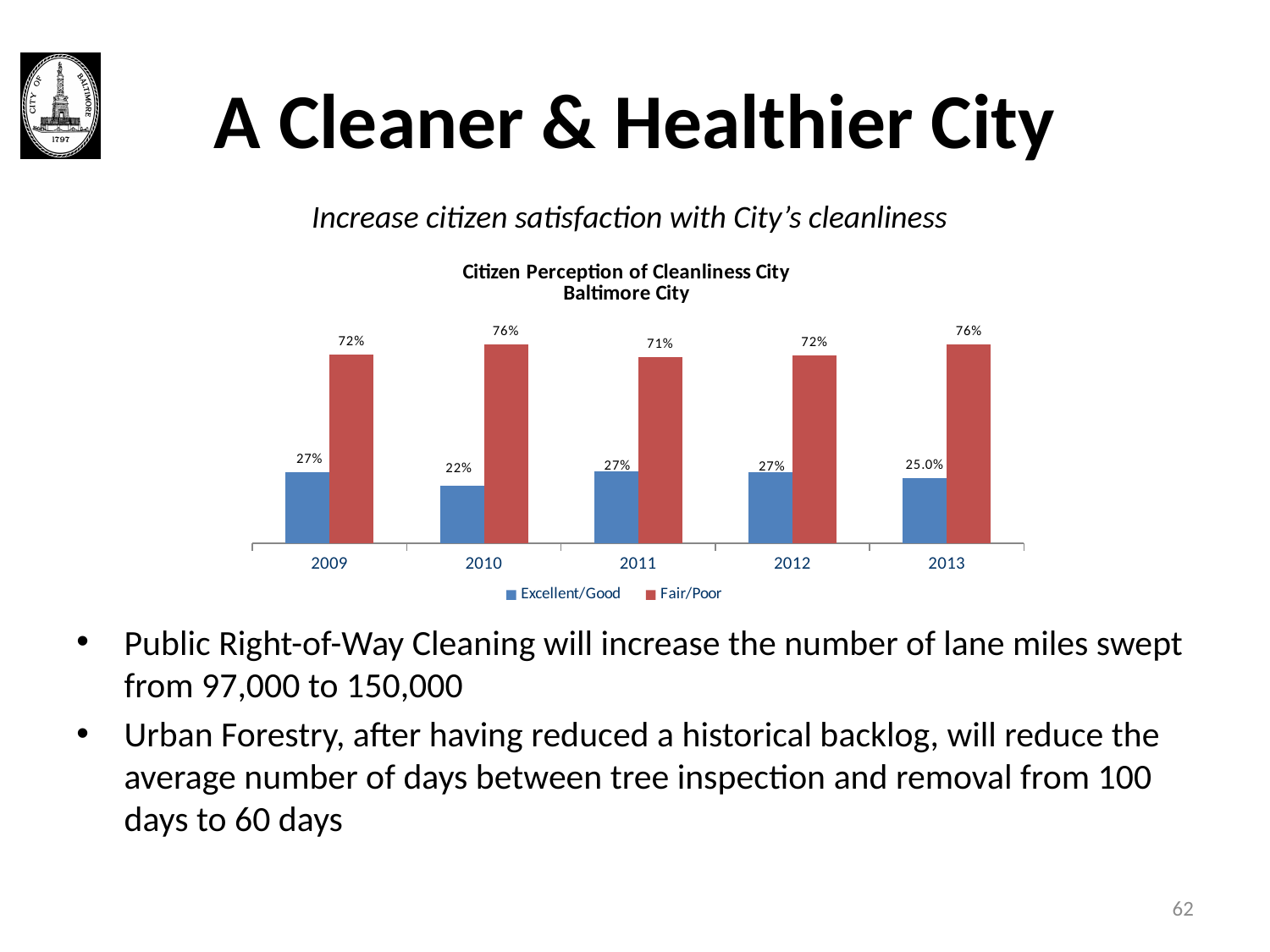
What is the Fair/Poor value for 2009? 72% What is the title of the chart? Citizen Perception of Cleanliness City Baltimore City What is the Excellent/Good value for 2010? 22% Which is larger in 2012, the Excellent/Good value or the Fair/Poor value? Fair/Poor Which year has the lowest Fair/Poor value? 2011 How many years are shown on the x axis? 5 How many series does the legend list? 2 What kind of chart is shown? Bar chart Which year has the lowest Excellent/Good value? 2010 What is the difference between the Fair/Poor and Excellent/Good values in 2010? 54% What is the Fair/Poor value for 2011? 71% What is the Excellent/Good value for 2013? 25.0%